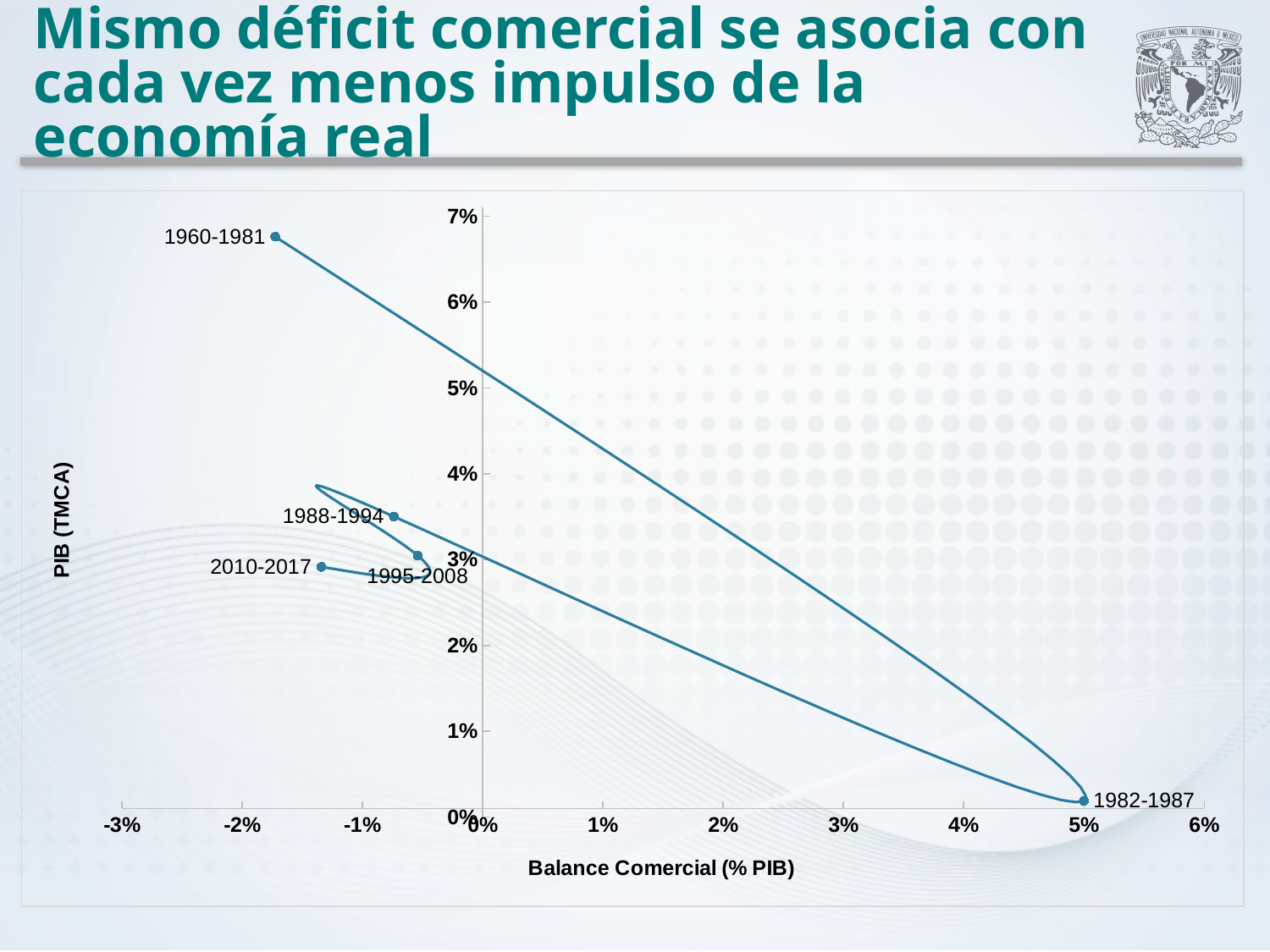
Which period has the highest PIB (TMCA) value? 1960-1981 Is the Balance Comercial value for 1982-1987 greater or less than 4%? greater Which period has the lowest Balance Comercial (% PIB)? 1960-1981 Which period has a higher PIB (TMCA): 1988-1994 or 2010-2017? 1988-1994 Is the PIB (TMCA) value for 1960-1981 greater or less than 6%? greater Which period has the highest Balance Comercial (% PIB)? 1982-1987 Is the Balance Comercial value for 2010-2017 greater or less than -1%? less Which period has the lowest PIB (TMCA) value? 1982-1987 How many labeled periods (data points) are plotted on the chart? 5 What is the title of the horizontal axis of the chart? Balance Comercial (% PIB) What kind of chart is shown on the slide? Scatter chart with connecting lines